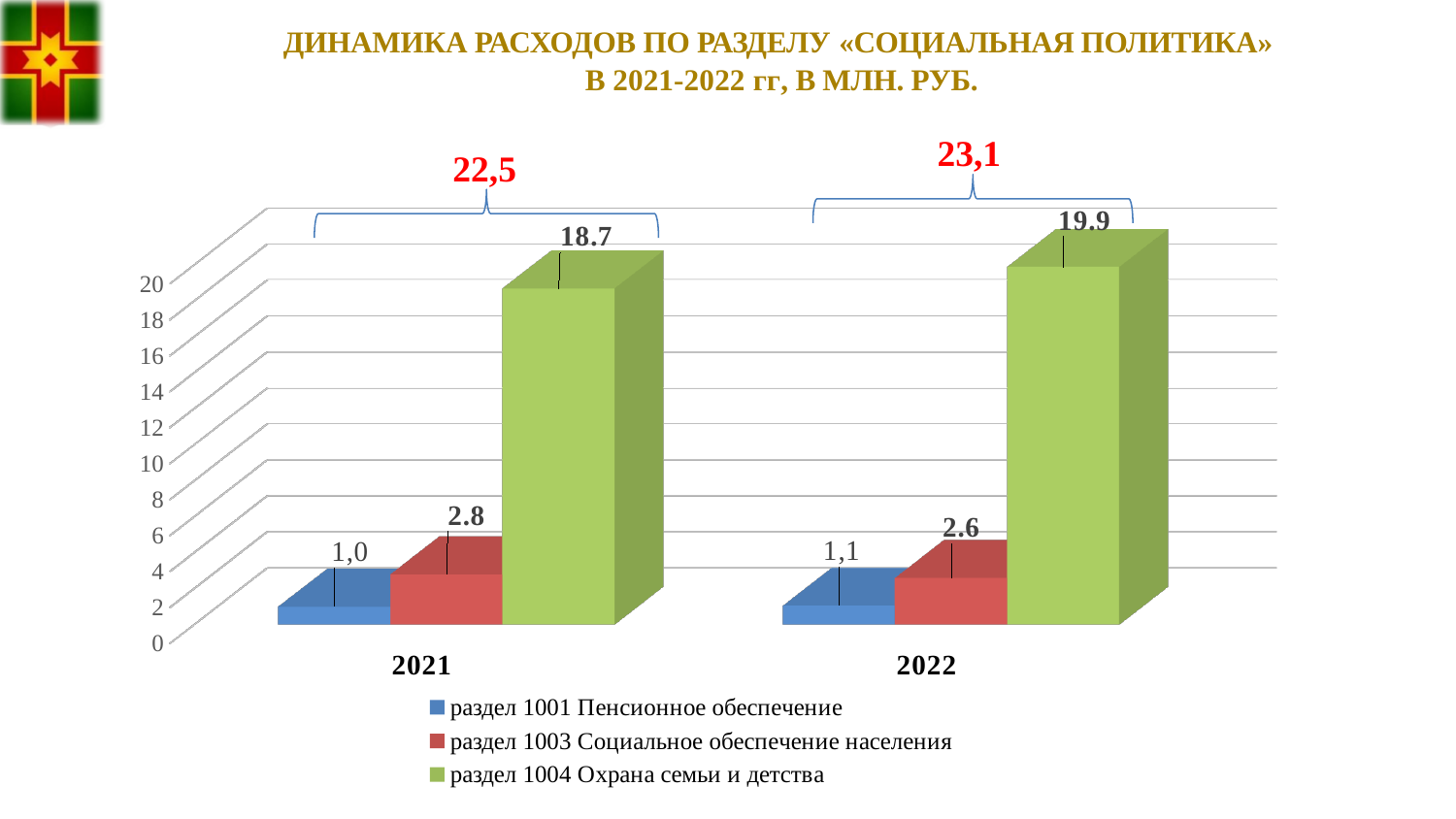
What is the value for раздел 1001 Пенсионное обеспечение in 2022? 1,1 How many categories are shown on the x axis? 2 Which is larger: раздел 1003 Социальное обеспечение населения in 2021 or in 2022? 2021 Which series has the lowest value in 2021? раздел 1001 Пенсионное обеспечение What is the value for раздел 1001 Пенсионное обеспечение in 2021? 1,0 What kind of chart is shown on the slide? bar chart What is the value for раздел 1003 Социальное обеспечение населения in 2022? 2.6 What total is shown above the bars for 2022? 23,1 What is the value for раздел 1004 Охрана семьи и детства in 2021? 18.7 What is the difference between the values for раздел 1004 Охрана семьи и детства in 2022 and 2021? 1.2 How many series does the legend list? 3 Which series has the highest value in 2022? раздел 1004 Охрана семьи и детства